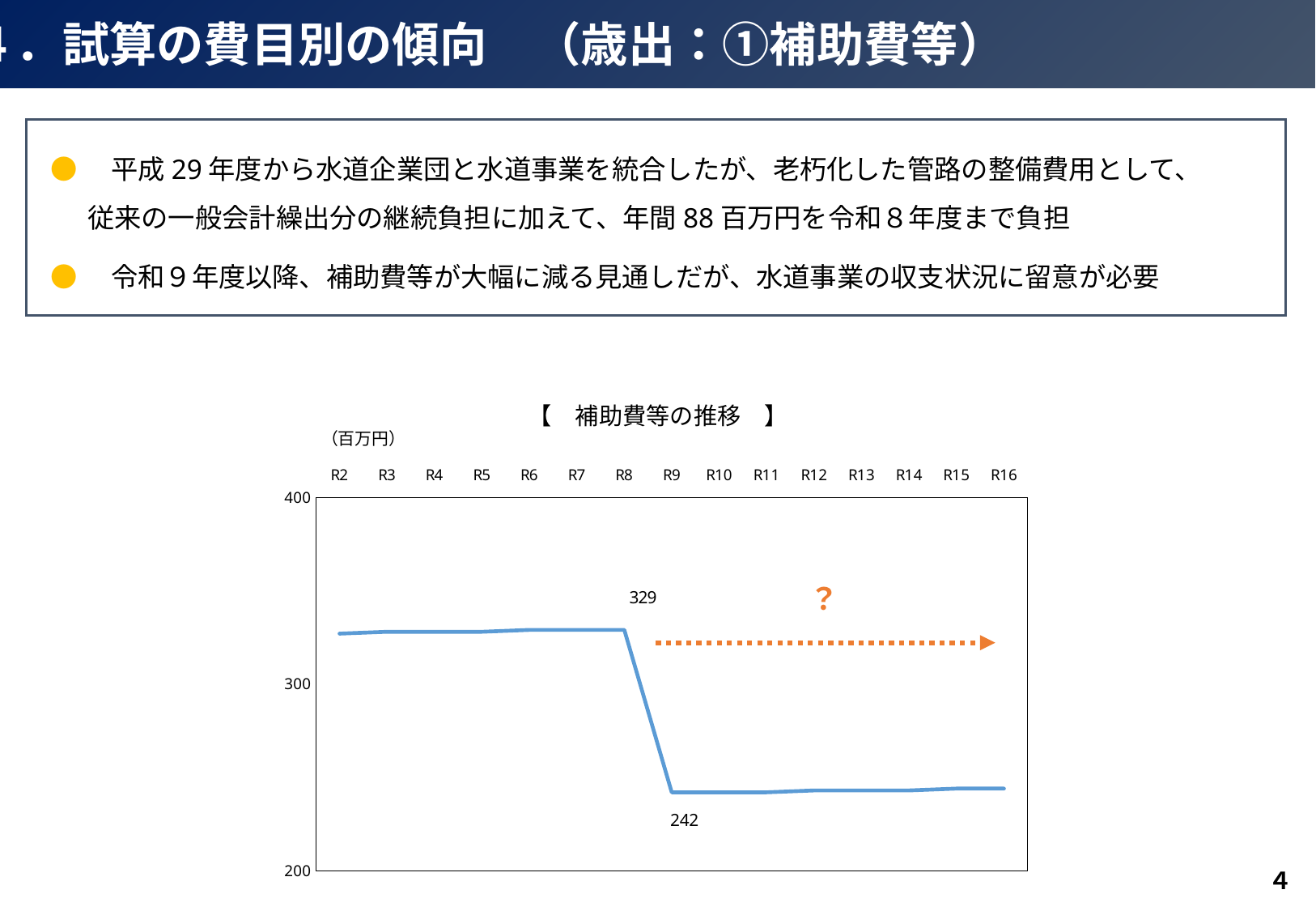
What is the value for R8 in the 補助費等の推移 chart? 329 Which is larger, the value for R8 or the value for R9? R8 Is the value for R12 greater or less than 300? less What kind of chart is shown on the slide? line chart What is the value for R9 in the 補助費等の推移 chart? 242 What is the title of the chart? 補助費等の推移 How many years (data points) are shown on the x axis of the chart? 15 What unit is shown for the chart's values? 百万円 What is the difference between the values for R8 and R9? 87 Do the values rise or fall from R8 to R9? fall Is the value for R16 greater or less than 300? less Is the value for R2 greater or less than 300? greater